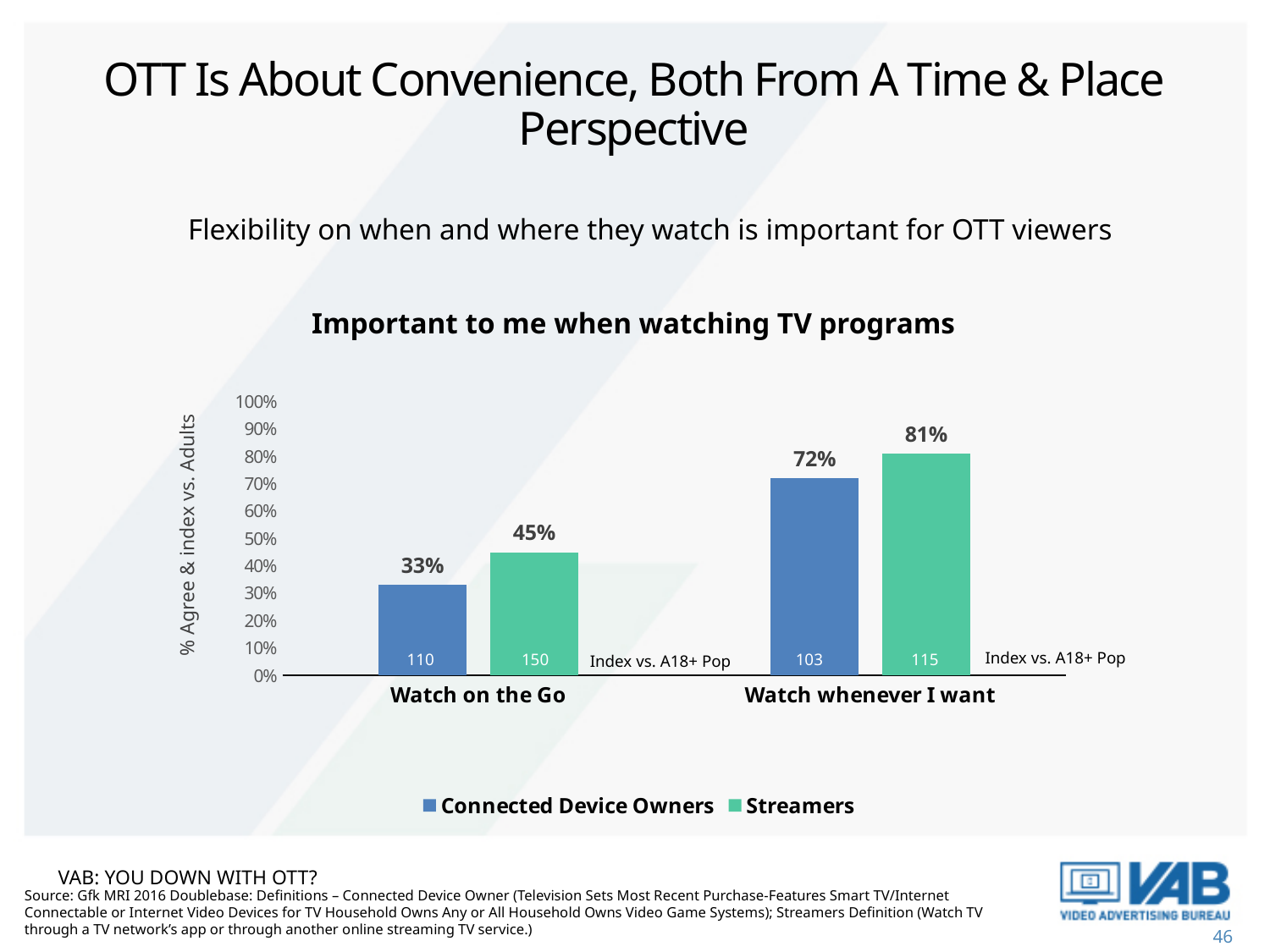
What percentage of Connected Device Owners say 'Watch on the Go' is important to them? 33% What is the index vs. A18+ Pop for Connected Device Owners on 'Watch whenever I want'? 103 Which group has a higher percentage for 'Watch on the Go', Connected Device Owners or Streamers? Streamers Which bar has the highest percentage in the chart? Streamers, Watch whenever I want What percentage of Streamers say 'Watch whenever I want' is important to them? 81% What type of chart is shown on the slide? Bar chart Which bar has the lowest percentage in the chart? Connected Device Owners, Watch on the Go How many series does the legend list? 2 What is the difference in percentage between Streamers and Connected Device Owners for 'Watch on the Go'? 12% What is the index vs. A18+ Pop for Streamers on 'Watch on the Go'? 150 What is the difference in percentage between Streamers and Connected Device Owners for 'Watch whenever I want'? 9% What is the title of the chart? Important to me when watching TV programs